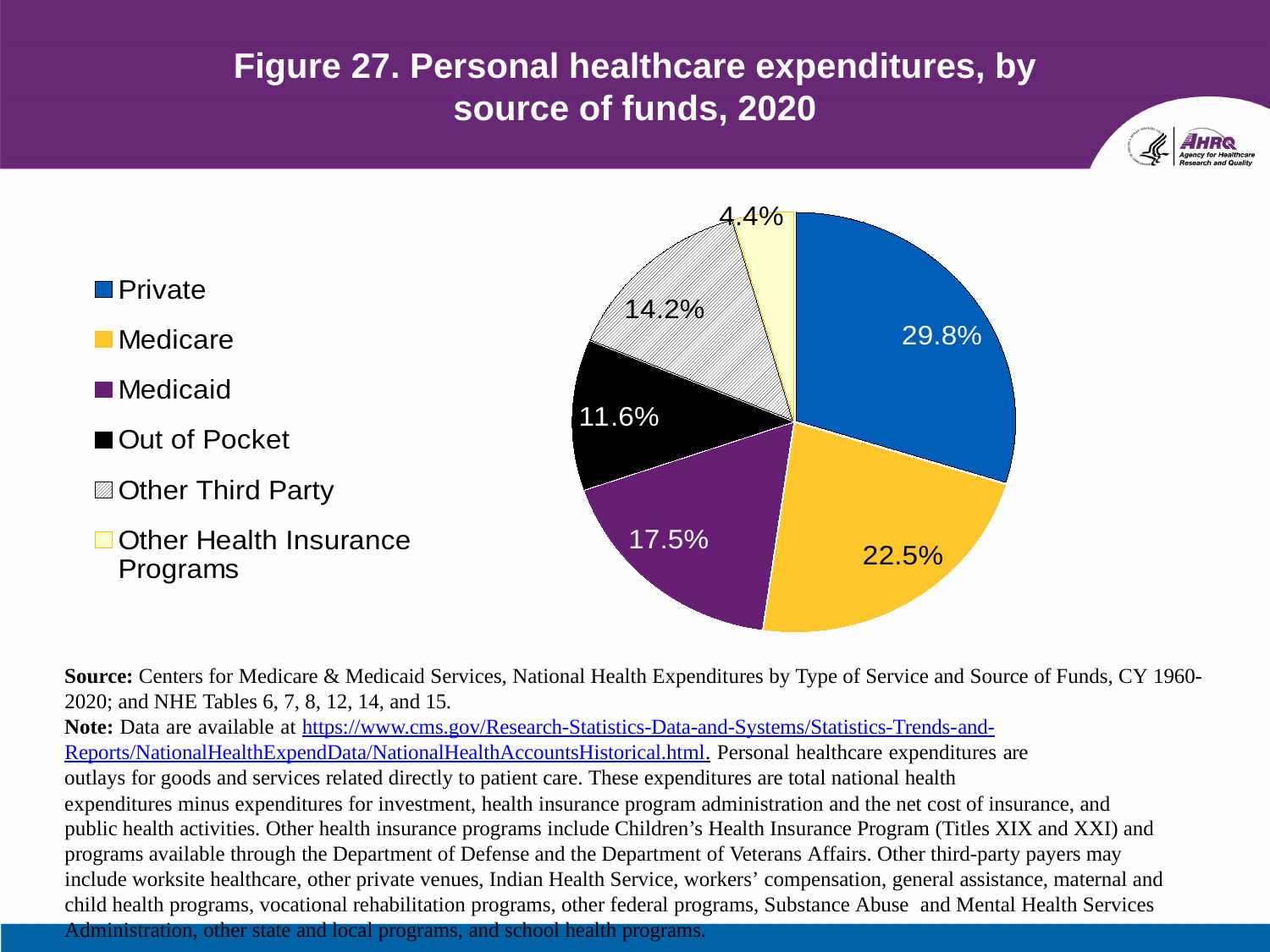
What percentage is shown for Other Third Party? 14.2% What is the difference in percentage points between the Private and Medicare shares? 7.3 What share is shown for Other Health Insurance Programs? 4.4% How many categories does the legend list? 6 Which source of funds has the largest share of the pie? Private What is the value shown for Medicaid? 17.5% Which source of funds has the smallest share of the pie? Other Health Insurance Programs What percentage of the pie is Medicare? 22.5% What share of personal healthcare expenditures came from Private sources in 2020? 29.8% What type of chart is shown on the slide? Pie chart What share is labeled for Out of Pocket? 11.6% Which is larger, the Other Third Party share or the Out of Pocket share? Other Third Party